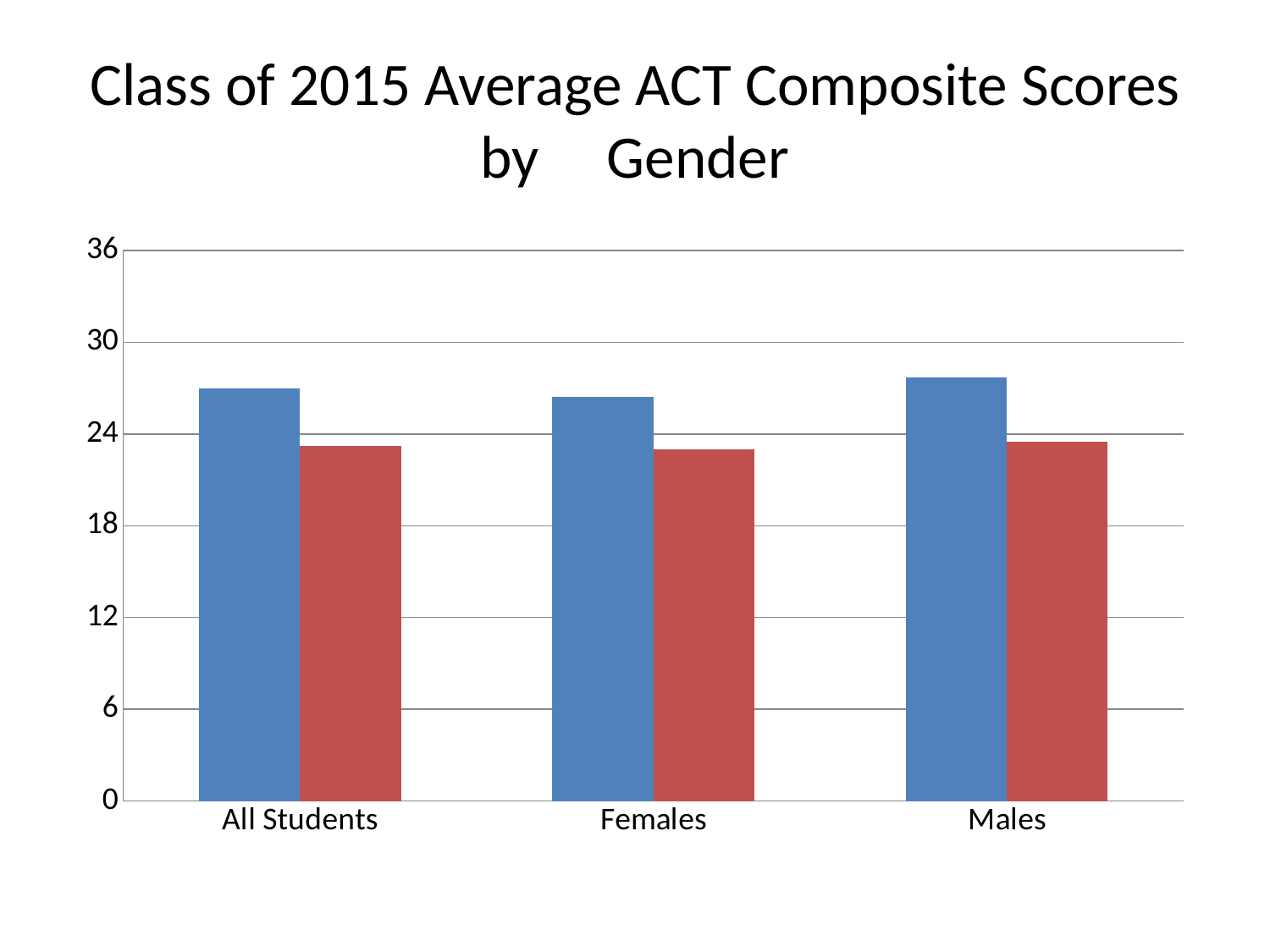
What kind of chart is shown on the slide? bar chart What is the highest value shown on the y axis? 36 Is the value of the red bar for Females greater or less than 18? greater Is the value of the blue bar for Males greater or less than 30? less How many bars are plotted for each category? 2 For Females, which bar is taller, the blue bar or the red bar? the blue bar For Males, which bar is shorter, the blue bar or the red bar? the red bar How many categories are shown on the x axis? 3 Is the value of the red bar for Males greater or less than 30? less What is the title of the chart? Class of 2015 Average ACT Composite Scores by Gender Which category has the tallest blue bar? Males